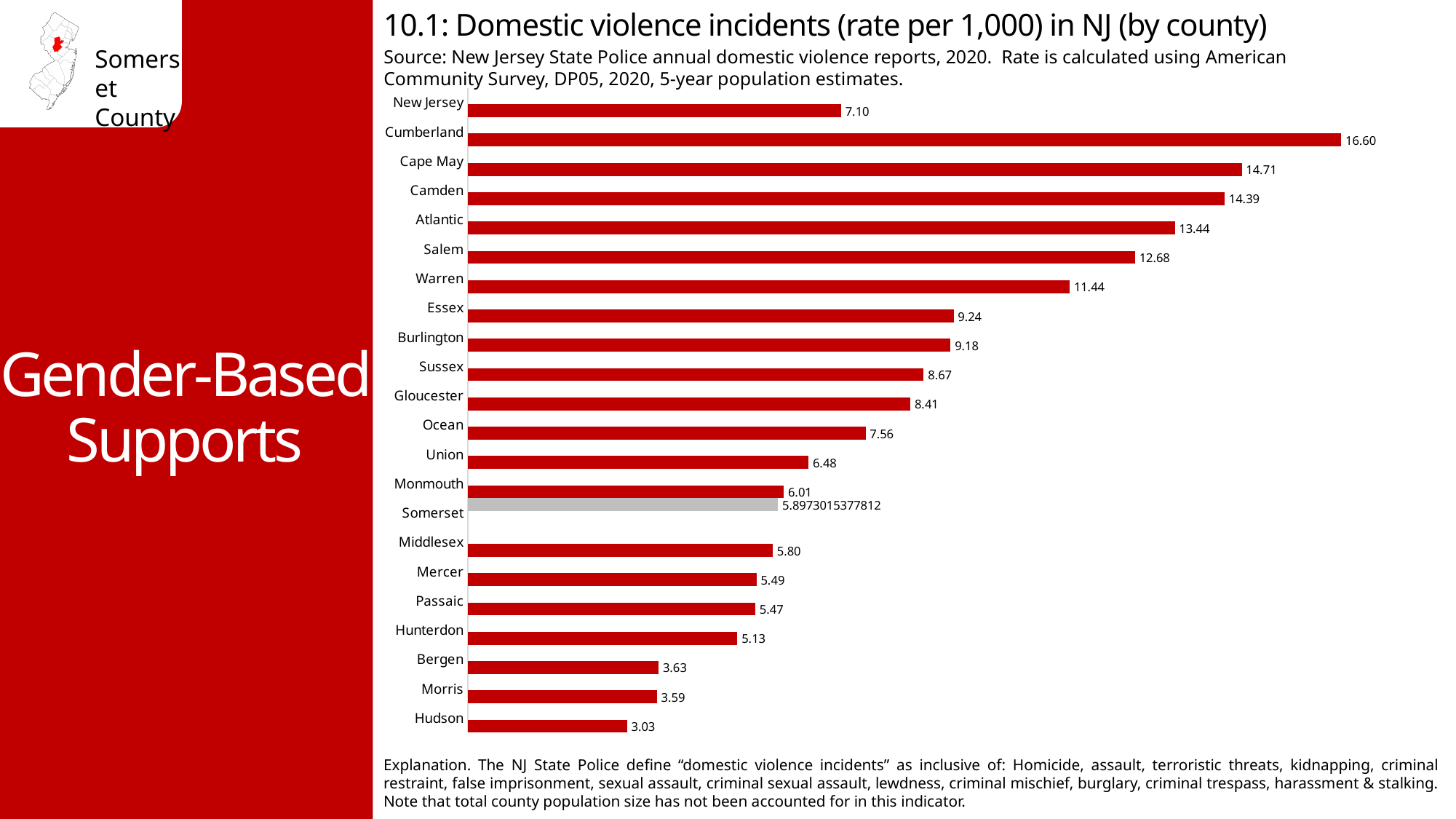
Which county has the highest domestic violence incident rate? Cumberland Which bar is coloured grey instead of red? Somerset Which has a higher rate, Monmouth or Middlesex? Monmouth Which county has the lowest domestic violence incident rate? Hudson How many bars (categories) are shown in the chart? 22 What is the rate per 1,000 shown for New Jersey overall? 7.10 What is the difference between the rates for Cumberland and Hudson? 13.57 What value is labelled on the Somerset bar? 5.8973015377812 Which has a higher rate, Cape May or Camden? Cape May What is the rate per 1,000 for Hudson county? 3.03 What is the domestic violence incident rate per 1,000 for Cumberland county? 16.60 What type of chart is used on this slide? Bar chart